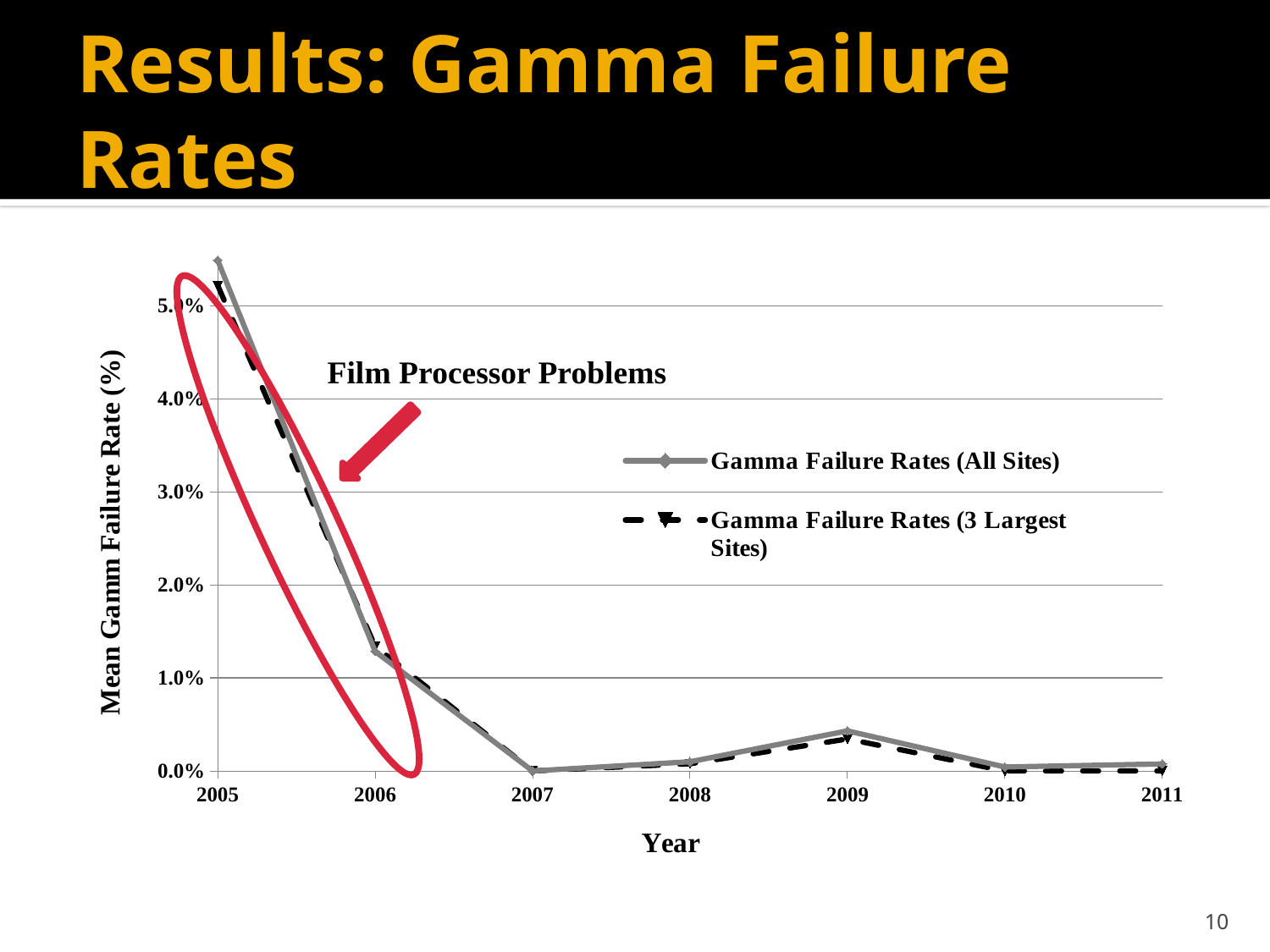
Do the Gamma Failure Rates (All Sites) values rise or fall from 2005 to 2007? fall What annotation text is written next to the red arrow on the chart? Film Processor Problems Is the Gamma Failure Rates (All Sites) value for 2006 greater or less than 2.0%? less How many series does the legend list? 2 Is the Gamma Failure Rates (All Sites) value for 2009 greater or less than 1.0%? less Is the Gamma Failure Rates (All Sites) value for 2005 greater or less than 5.0%? greater In 2005, which series has the higher value, Gamma Failure Rates (All Sites) or Gamma Failure Rates (3 Largest Sites)? Gamma Failure Rates (All Sites) In which year is the Gamma Failure Rates (All Sites) value highest? 2005 How many years are plotted along the x axis? 7 For Gamma Failure Rates (All Sites), which year has the larger value, 2008 or 2009? 2009 What kind of chart is shown on the slide? line chart